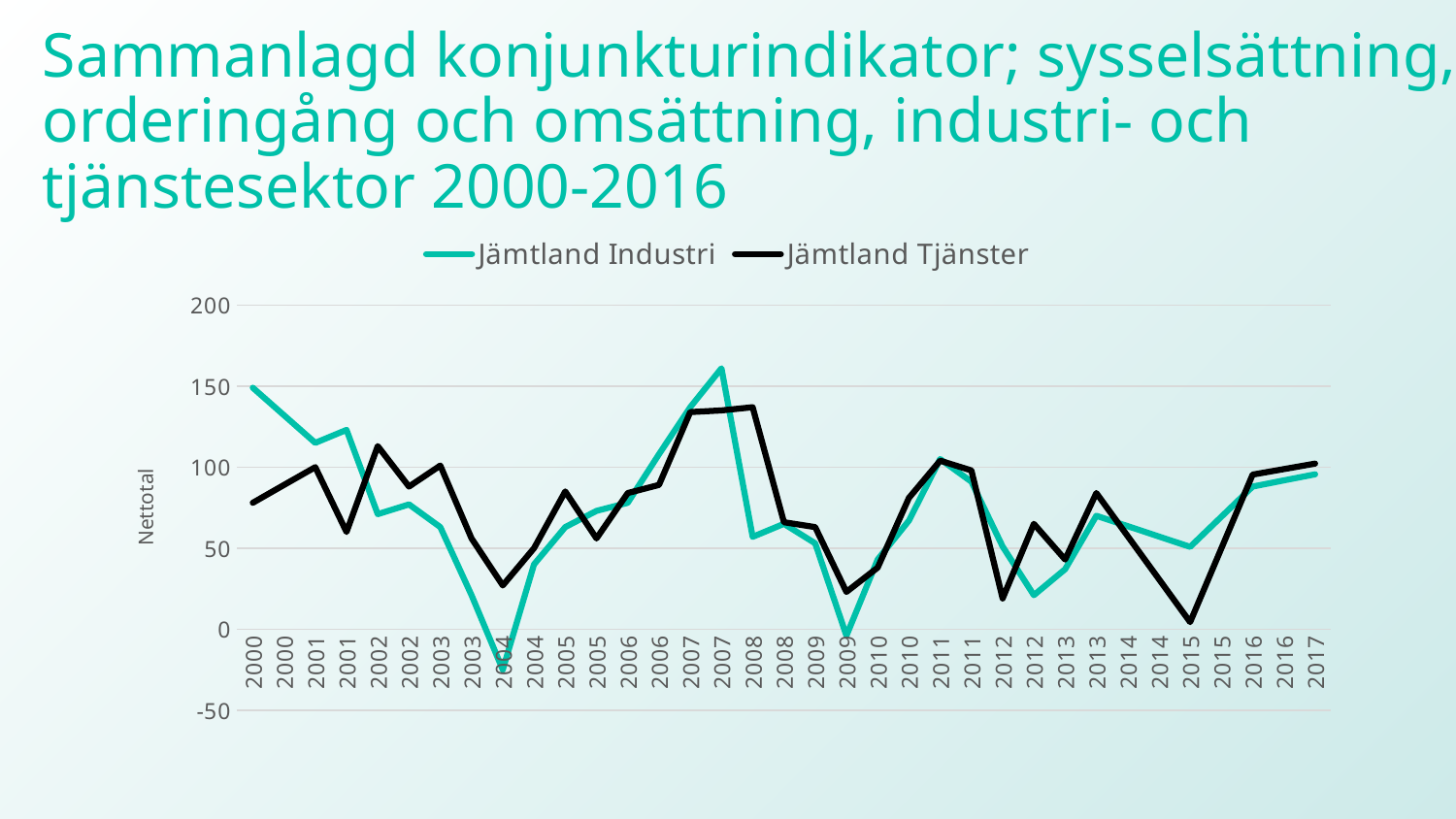
In which year does Jämtland Industri reach its highest value? 2007 What kind of chart is shown on the slide? line chart Does the Jämtland Industri line rise or fall from 2015 to 2017? rise Is the value for Jämtland Industri at the first 2000 point greater or less than 100? greater At the first 2000 point, which series has the higher value, Jämtland Industri or Jämtland Tjänster? Jämtland Industri Is the value for Jämtland Tjänster at the first 2015 point greater or less than 50? less Is the lowest value for Jämtland Industri (at 2004) greater or less than 0? less What is the label on the vertical axis? Nettotal What are the two series named in the legend? Jämtland Industri and Jämtland Tjänster How many series does the legend list? 2 In which year does Jämtland Tjänster reach its lowest value? 2015